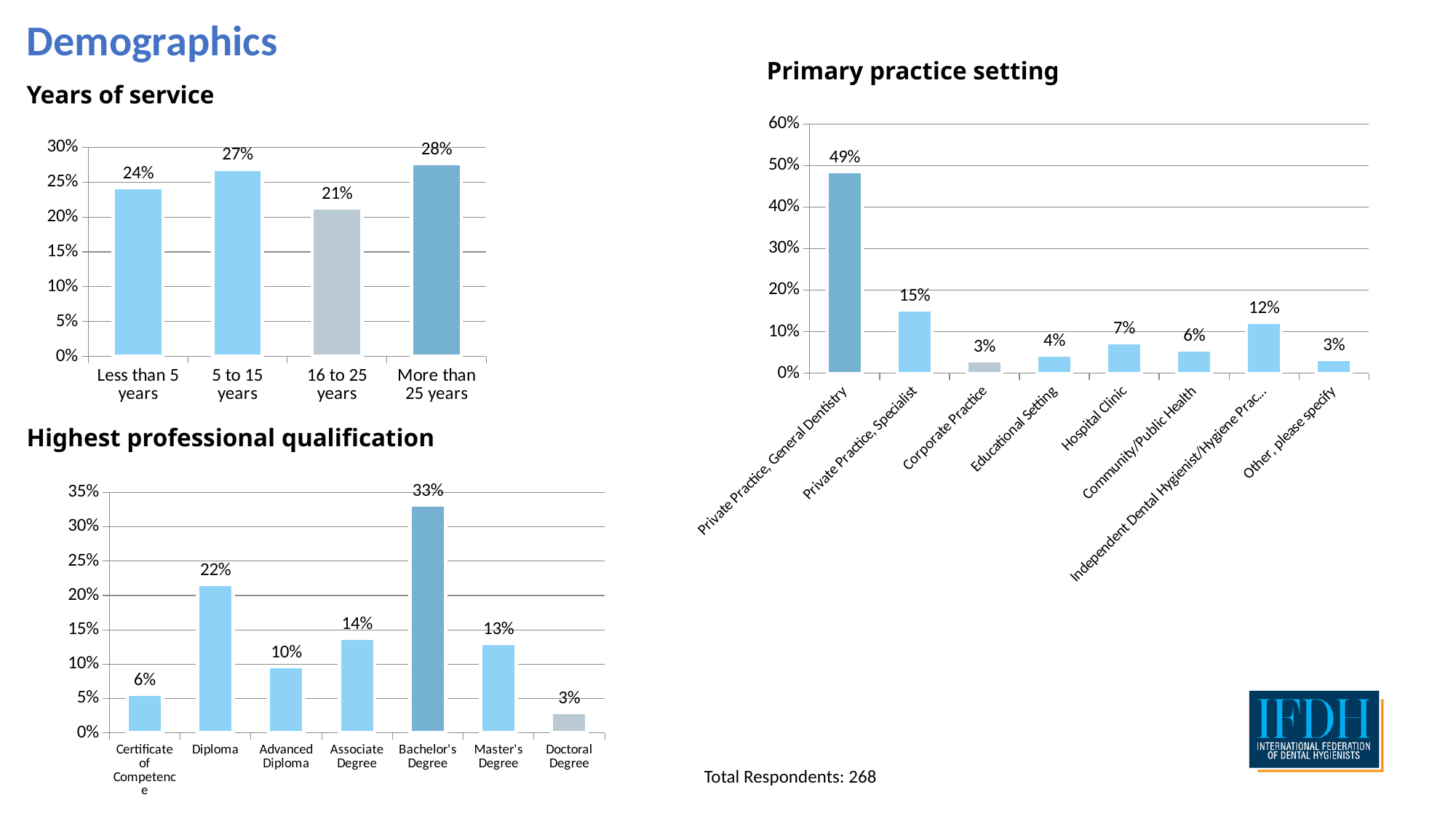
In the Years of service chart, how many categories are shown? 4 In the Highest professional qualification chart, what is the difference between Diploma and Advanced Diploma? 12% In the Highest professional qualification chart, which category has the highest value? Bachelor's Degree In the Primary practice setting chart, what is the difference between Private Practice, General Dentistry and Independent Dental Hygienist/Hygiene Prac...? 37% In the Years of service chart, which category has the highest value? More than 25 years In the Primary practice setting chart, which is larger, Hospital Clinic or Community/Public Health? Hospital Clinic In the Primary practice setting chart, what is the value for Private Practice, Specialist? 15% In the Highest professional qualification chart, how many categories are shown? 7 In the Years of service chart, which category has the lowest value? 16 to 25 years In the Years of service chart, what is the value for 5 to 15 years? 27% In the Highest professional qualification chart, what is the value for Associate Degree? 14% What kind of chart is the Primary practice setting chart? Bar chart